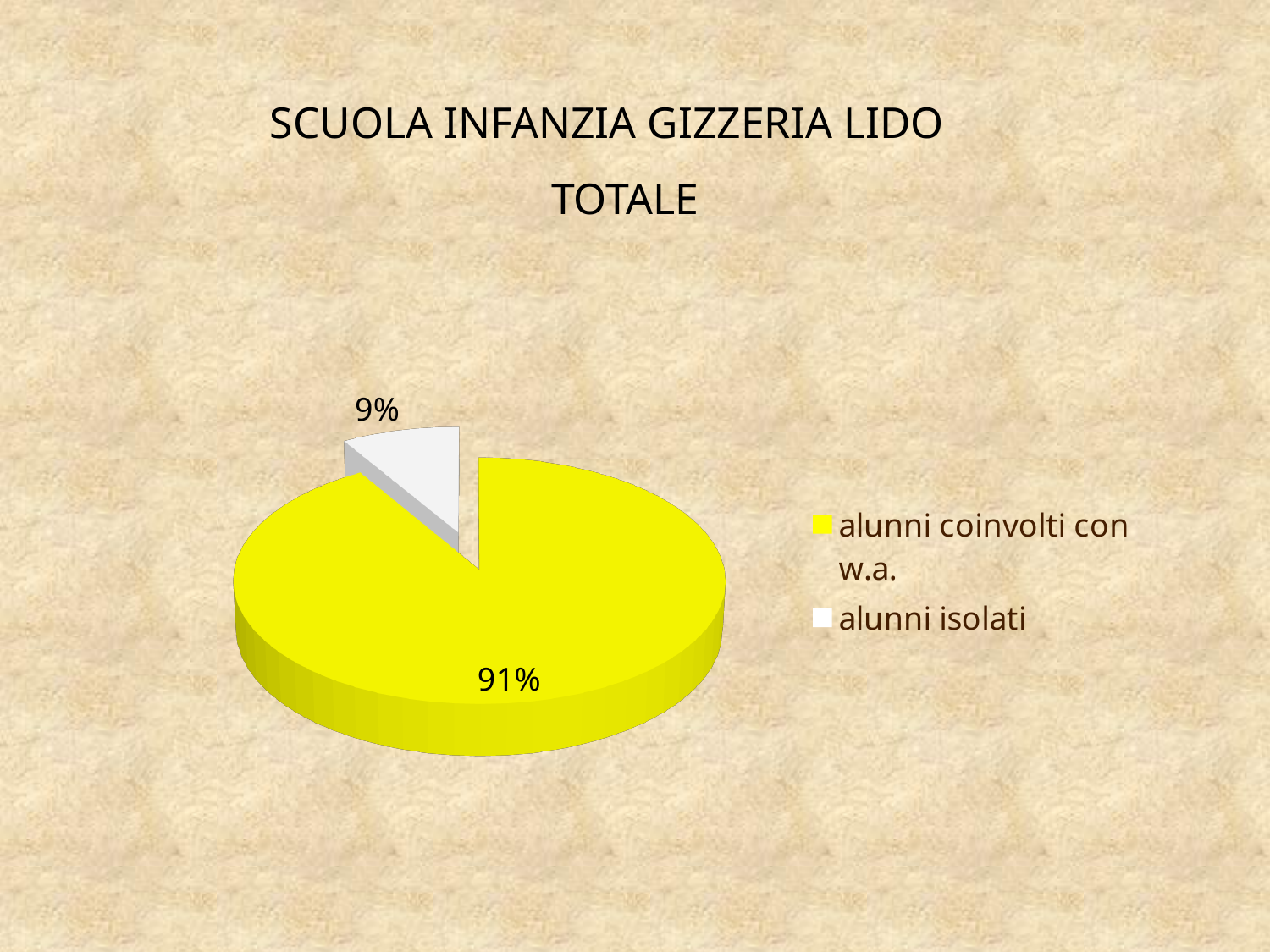
What share of the pie does the "alunni isolati" slice represent? 9% Which slice is larger, "alunni coinvolti con w.a." or "alunni isolati"? alunni coinvolti con w.a. Which category has the largest slice of the pie? alunni coinvolti con w.a. What is the title of the chart? SCUOLA INFANZIA GIZZERIA LIDO TOTALE What percentage of the pie is labelled for "alunni coinvolti con w.a."? 91% How many entries does the legend list? 2 What percentage of the pie is labelled for "alunni isolati"? 9% Which category has the smallest slice of the pie? alunni isolati What is the difference in percentage points between the "alunni coinvolti con w.a." slice and the "alunni isolati" slice? 82 What colour is the slice for "alunni coinvolti con w.a."? yellow How many slices does the pie chart have? 2 What kind of chart is shown on the slide? pie chart